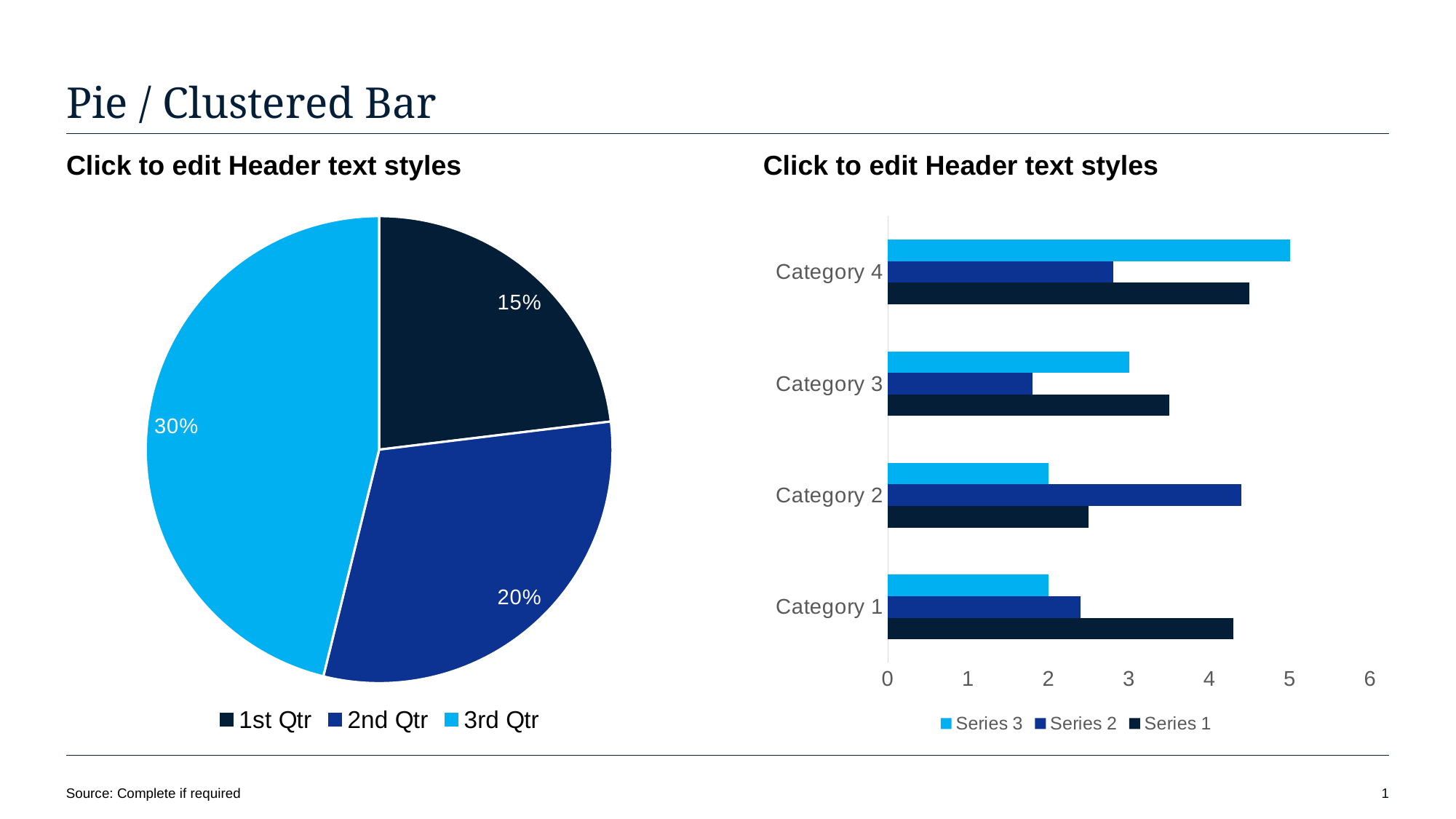
On the pie chart on the left, which quarter has the smallest slice? 1st Qtr On the pie chart on the left, how many slices are there? 3 On the bar chart on the right, is the value of Series 2 for Category 3 greater or less than 2? less On the pie chart on the left, what percentage is shown for 1st Qtr? 15% What kind of chart is on the right of the slide? Bar chart On the pie chart on the left, what is the difference between the labelled values for 3rd Qtr and 2nd Qtr? 10% On the pie chart on the left, what percentage is shown for 3rd Qtr? 30% On the bar chart on the right, how many series does the legend list? 3 On the bar chart on the right, for Category 2, which is larger: Series 1 or Series 2? Series 2 On the bar chart on the right, how many categories are shown? 4 On the pie chart on the left, which quarter has the largest slice? 3rd Qtr On the bar chart on the right, is the value of Series 3 for Category 4 greater or less than 4? greater